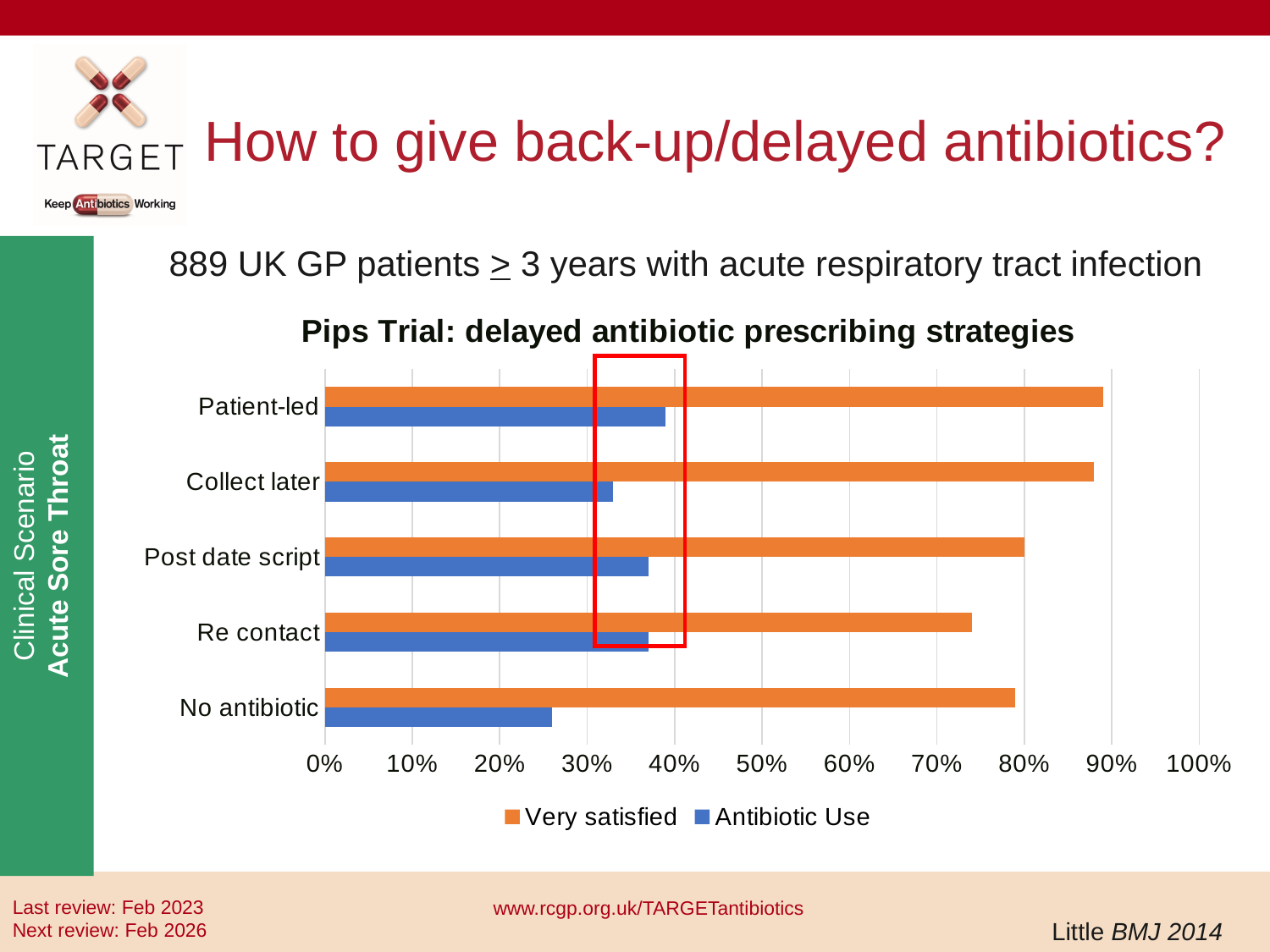
Which strategy has the lowest Antibiotic Use value? No antibiotic Is the Very satisfied value for Patient-led greater or less than 80%? greater How many prescribing strategies (categories) are shown on the chart? 5 Is the Antibiotic Use value for No antibiotic greater or less than 30%? less Which strategy has the lowest Very satisfied value? Re contact How many series does the chart legend list? 2 What is the title of the chart? Pips Trial: delayed antibiotic prescribing strategies Which series is shown in orange? Very satisfied Which has the higher Very satisfied value, Patient-led or Re contact? Patient-led What kind of chart is shown on the slide? Bar chart For Collect later, which is larger: Very satisfied or Antibiotic Use? Very satisfied Is the Very satisfied value for Re contact greater or less than 80%? less